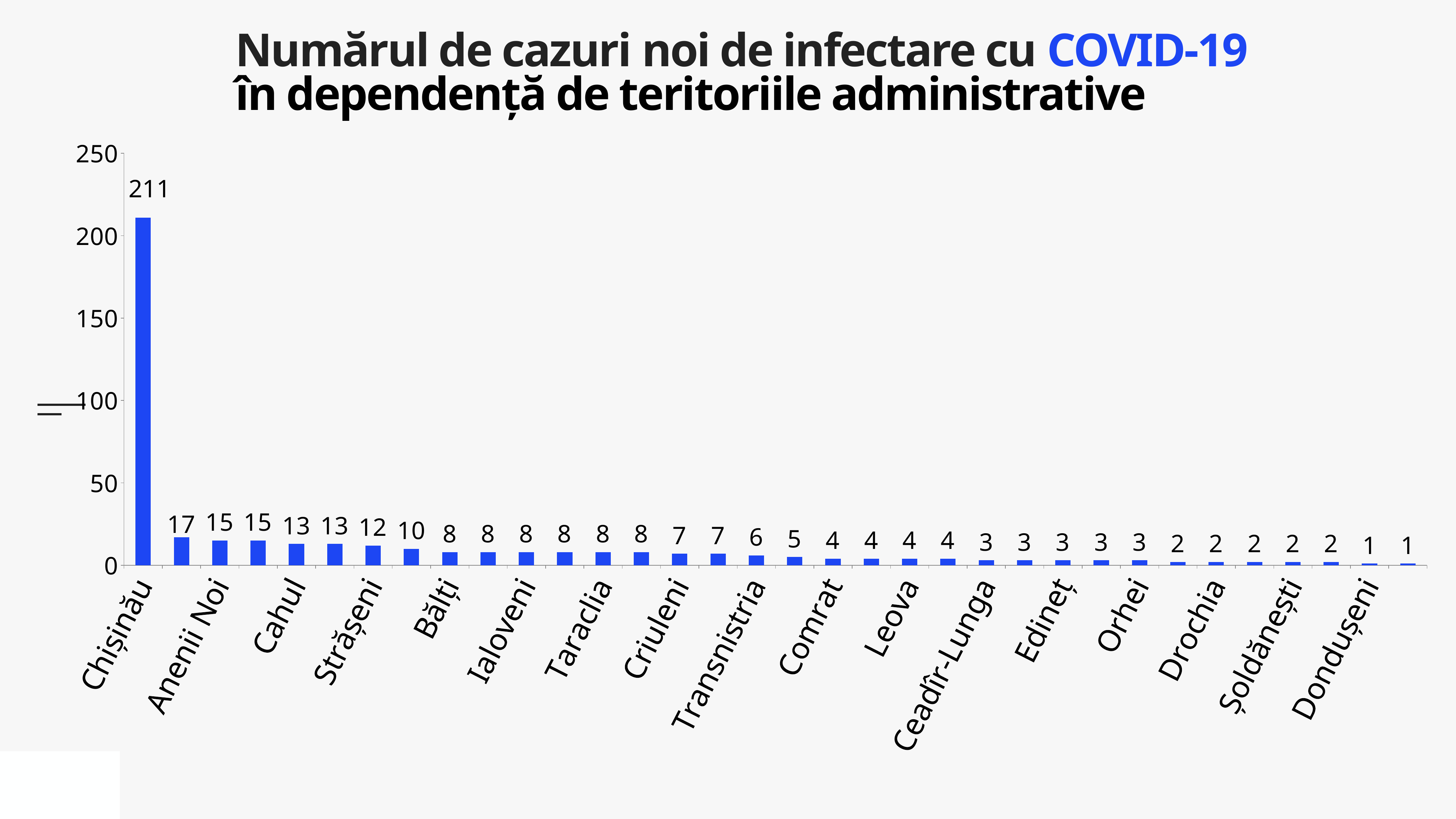
What is the number of new COVID-19 cases for Chișinău? 211 What is the highest value shown on the vertical axis? 250 What is the number of new cases for Dondușeni? 1 Which territory has the highest number of new cases? Chișinău What is the number of new cases for Edineț? 3 Do the values rise or fall from left to right along the x axis? fall What type of chart is shown on the slide? bar chart What is the number of new cases for Leova? 4 Is the value for Chișinău greater or less than 200? greater What is the difference between the values for Chișinău and Bălți? 203 Which has more new cases, Ialoveni or Șoldănești? Ialoveni What is the number of new cases for Bălți? 8